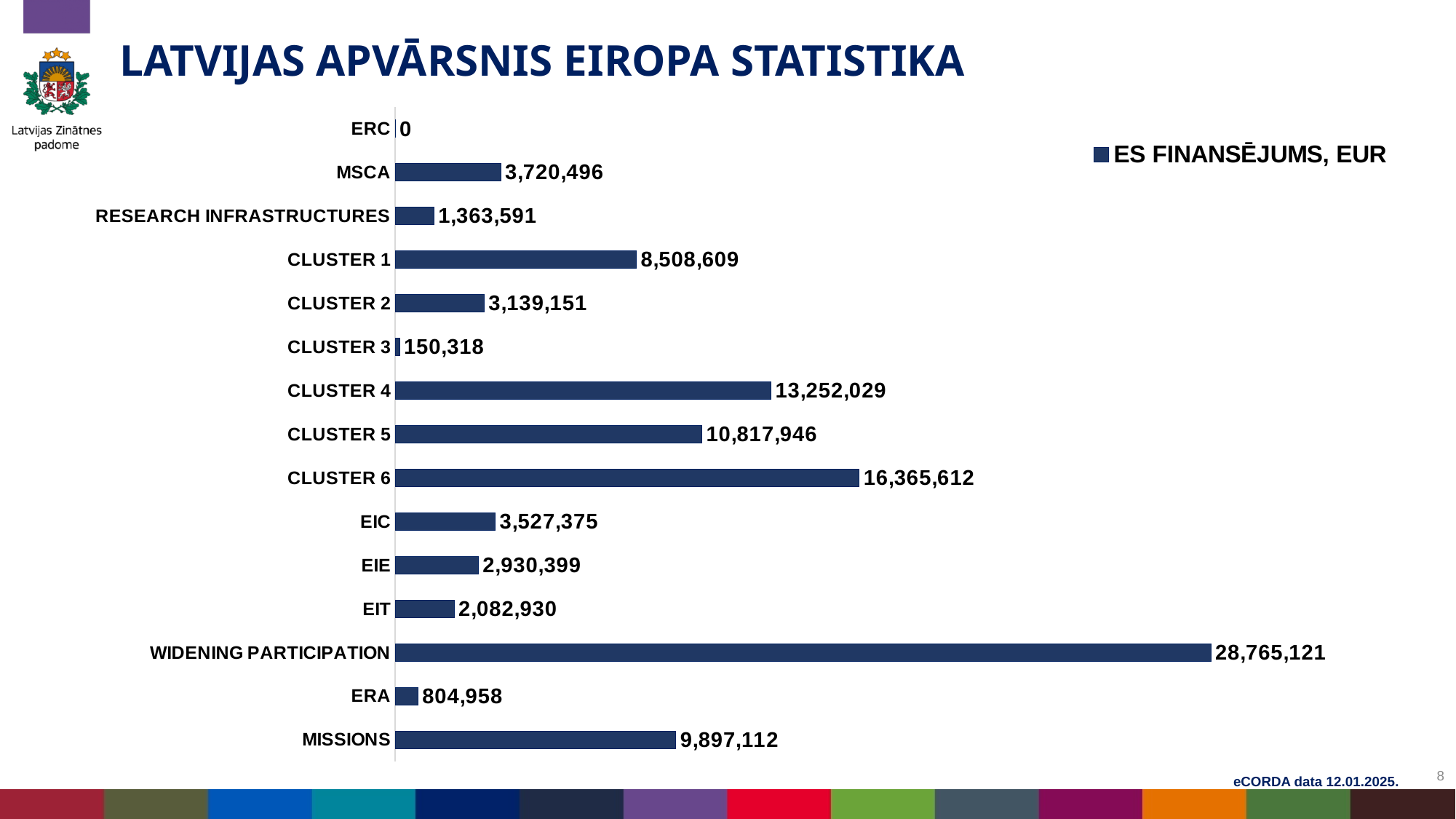
What kind of chart is shown on the slide? Bar chart How many categories are shown in the chart? 15 What is the value for RESEARCH INFRASTRUCTURES? 1,363,591 What is the difference between the values for CLUSTER 6 and CLUSTER 5? 5,547,666 Which category has the highest value? WIDENING PARTICIPATION What is the value for CLUSTER 4? 13,252,029 What is the difference between the values for WIDENING PARTICIPATION and CLUSTER 4? 15,513,092 Which category has the lowest value? ERC What is the value for WIDENING PARTICIPATION? 28,765,121 How many series does the legend list? 1 Which is larger, the value for CLUSTER 1 or the value for CLUSTER 2? CLUSTER 1 What is the value for MISSIONS? 9,897,112